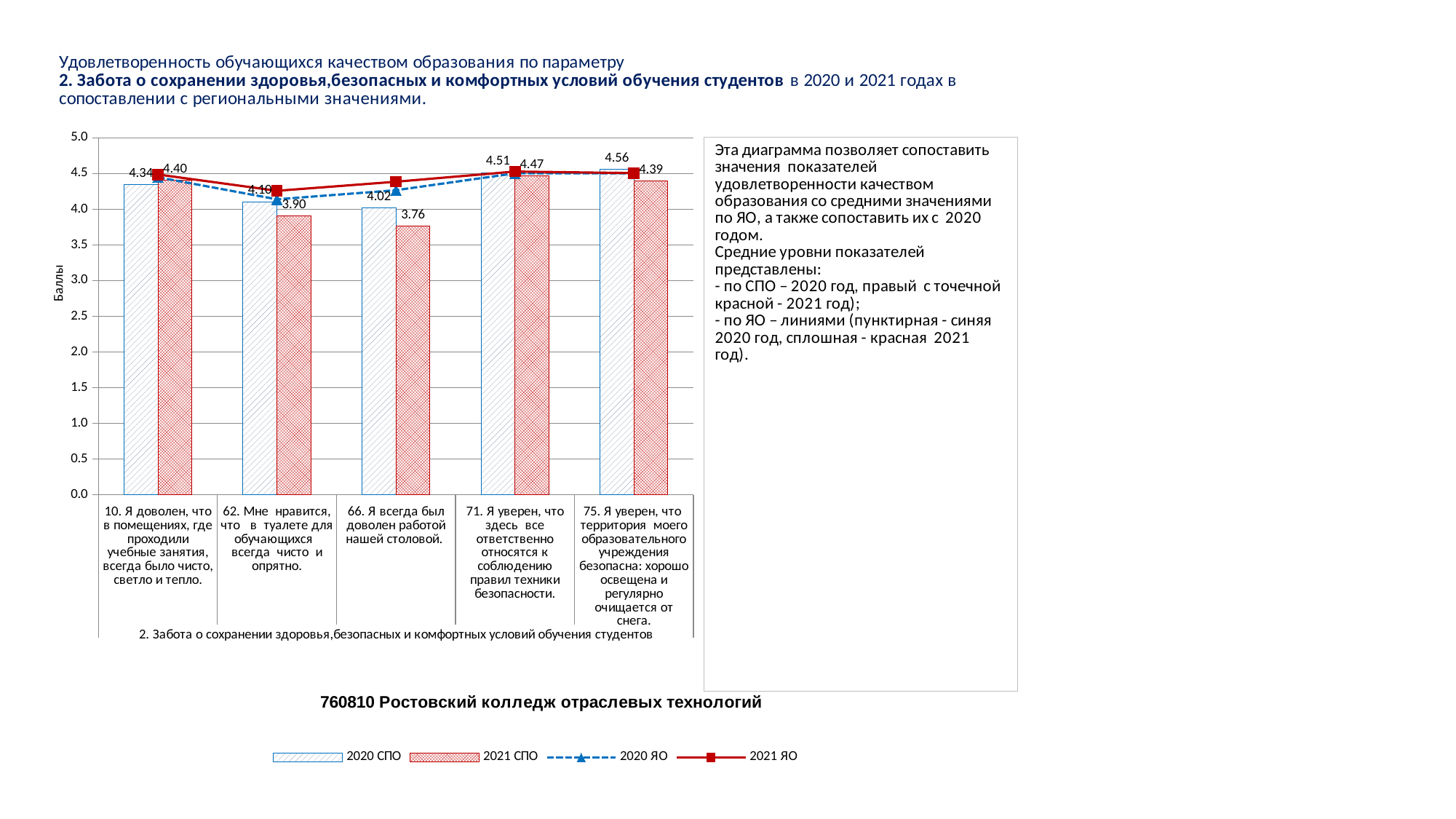
Which item has the lowest 2021 СПО value? 66 How many items (categories) are shown on the x axis? 5 What is the 2021 СПО value for item 66 (Я всегда был доволен работой нашей столовой)? 3.76 What is the 2020 СПО value for item 62 (в туалете для обучающихся всегда чисто и опрятно)? 4.10 What is the label of the vertical axis? Баллы Is the 2021 ЯО value for item 66 greater or less than 4.0? greater Which item has the highest 2020 СПО value? 75 How many series does the legend list? 4 What is the 2020 СПО value for item 75 (территория моего образовательного учреждения безопасна)? 4.56 What is the difference between the 2020 СПО and 2021 СПО values for item 75? 0.17 For item 10, which is larger: the 2020 СПО value or the 2021 СПО value? 2021 СПО What is the difference between the 2020 СПО and 2021 СПО values for item 66? 0.26